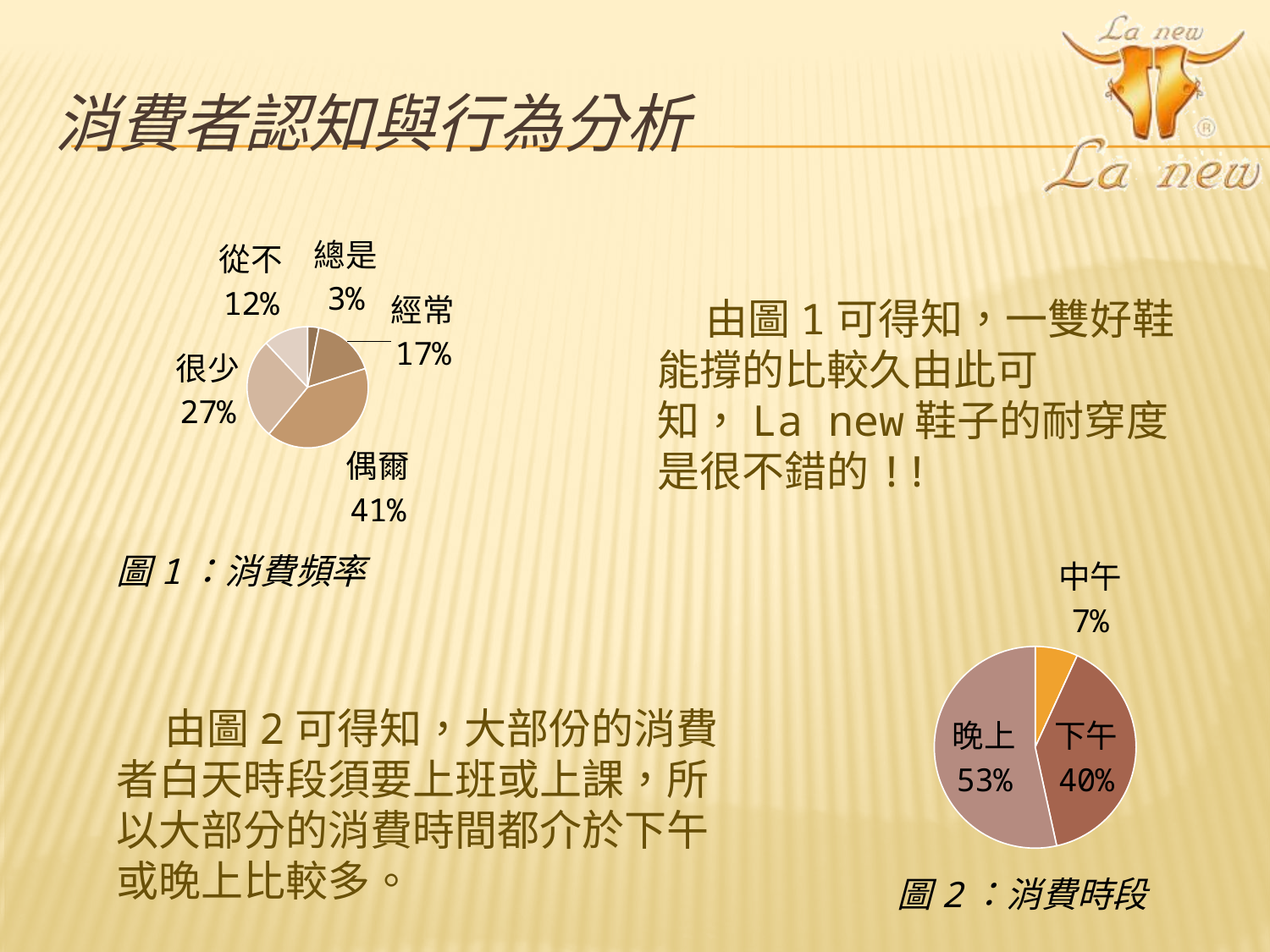
In the 圖2：消費時段 pie chart, how many categories are shown? 3 In the 圖1：消費頻率 pie chart, what share is labelled for 偶爾? 41% In the 圖1：消費頻率 pie chart, which is larger, the share for 經常 or the share for 很少? 很少 In the 圖2：消費時段 pie chart, what is the difference between the shares for 晚上 and 下午? 13% In the 圖1：消費頻率 pie chart, which category has the largest share? 偶爾 In the 圖1：消費頻率 pie chart, what share is labelled for 總是? 3% In the 圖2：消費時段 pie chart, which category has the smallest share? 中午 In the 圖2：消費時段 pie chart, what share is labelled for 晚上? 53% In the 圖1：消費頻率 pie chart, what is the difference between the shares for 很少 and 從不? 15% In the 圖1：消費頻率 pie chart, which category has the smallest share? 總是 In the 圖1：消費頻率 pie chart, how many categories are shown? 5 What kind of chart is 圖2：消費時段? Pie chart